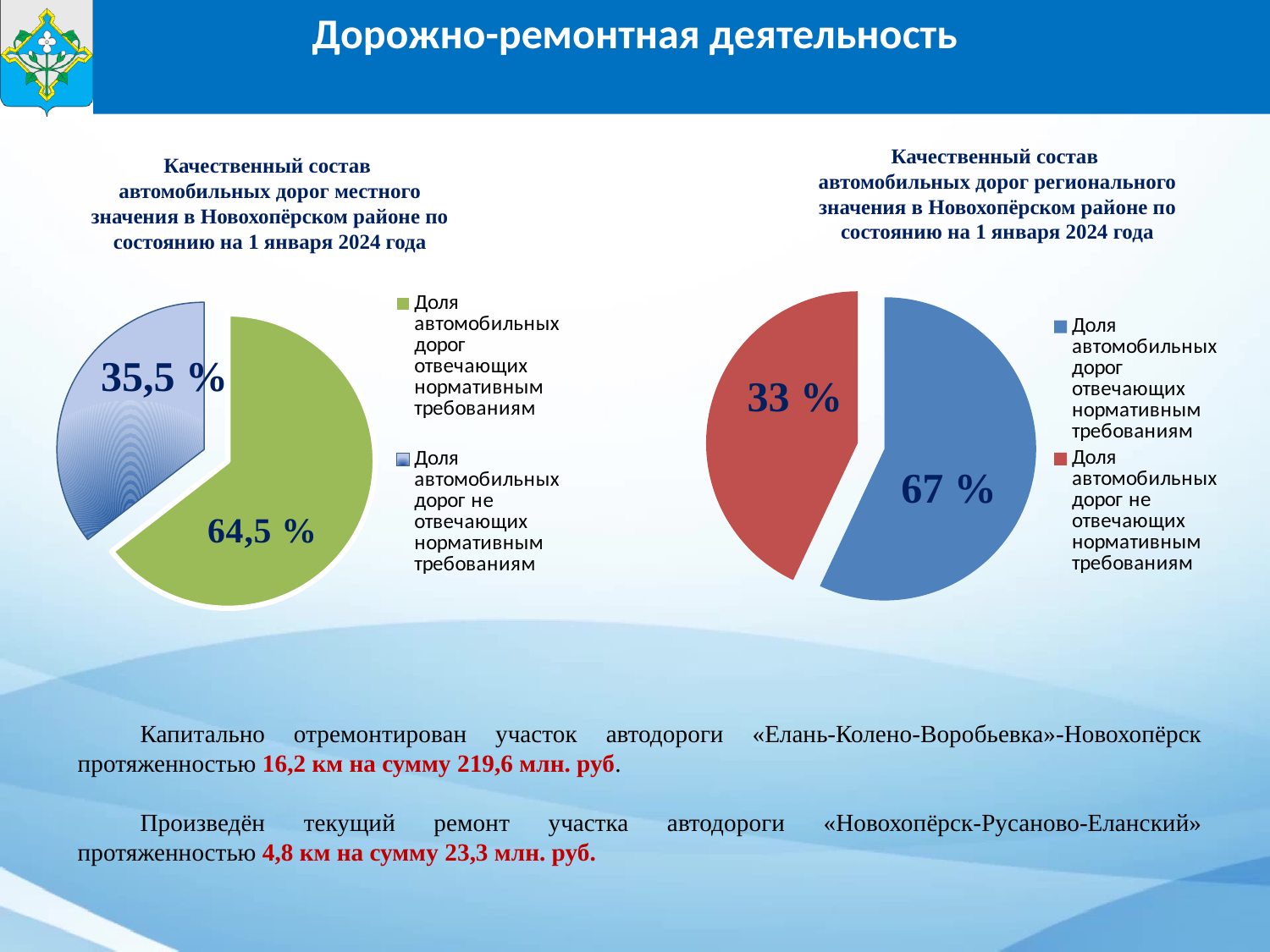
In the left pie chart (local roads), which slice is larger: roads meeting requirements or roads not meeting requirements? Roads meeting requirements In the left pie chart (local roads), what share of roads meets regulatory requirements? 64,5 % In the right pie chart (regional roads), what is the difference between the share of roads meeting requirements and the share not meeting them? 34 % In the left pie chart (local roads), what share of roads does not meet regulatory requirements? 35,5 % In the right pie chart (regional roads), what share of roads does not meet regulatory requirements? 33 % In the right pie chart (regional roads), what share of roads meets regulatory requirements? 67 % How many slices does the right pie chart (regional roads) have? 2 In the right pie chart (regional roads), which category has the smallest slice? Roads not meeting regulatory requirements In the left pie chart (local roads), what is the difference between the share of roads meeting requirements and the share not meeting them? 29 % How many entries does the legend of the left pie chart (local roads) list? 2 What type of chart is used on the left side of the slide for local roads? Pie chart In the right pie chart (regional roads), what colour is the slice for roads not meeting regulatory requirements? Red